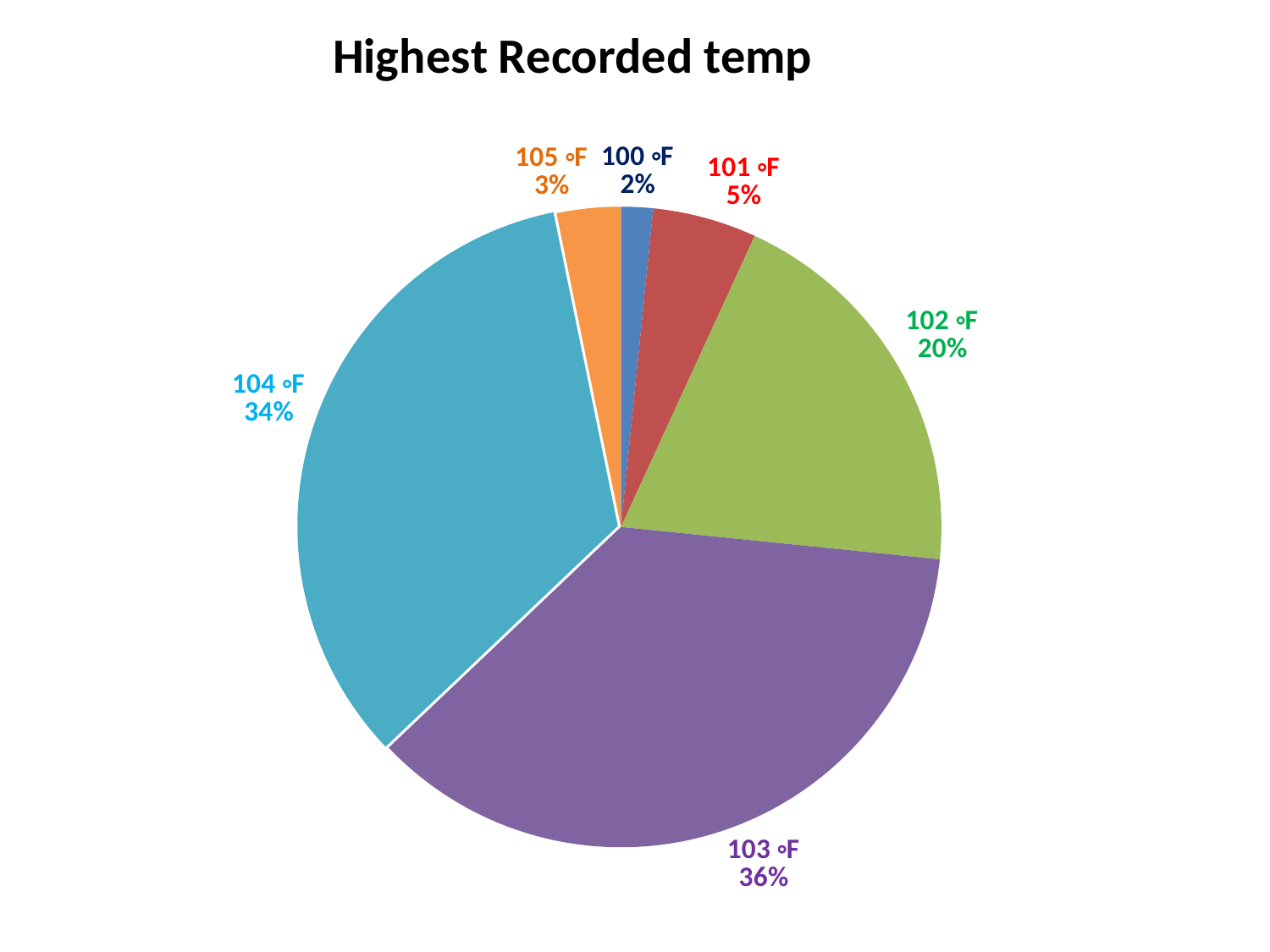
What is the difference in percentage points between the 102 °F slice and the 101 °F slice? 15 How many slices does the pie chart have? 6 What share of the pie does the 104 °F slice represent? 34% Which temperature has the largest slice of the pie? 103 °F What kind of chart is shown on the slide? pie chart What colour is the 104 °F slice? teal blue Which slice is larger, 105 °F or 101 °F? 101 °F Which temperature has the smallest slice of the pie? 100 °F What percentage is shown for 100 °F? 2% What is the title of the chart? Highest Recorded temp What share of the pie does the 103 °F slice represent? 36% What percentage is shown for 102 °F? 20%